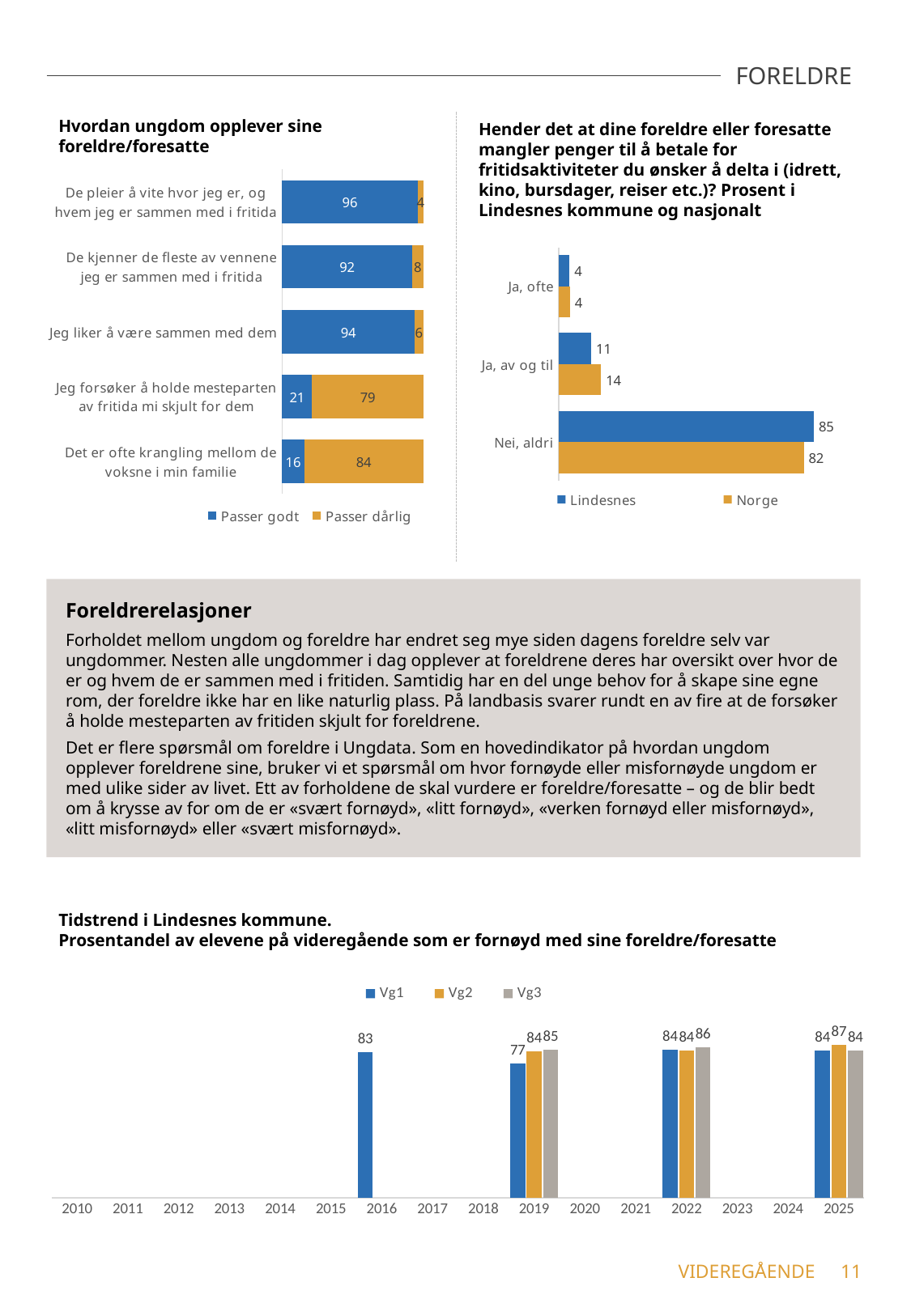
In the chart 'Hvordan ungdom opplever sine foreldre/foresatte', how many series does the legend list? 2 In the chart 'Hender det at dine foreldre eller foresatte mangler penger...', how many categories are shown? 3 In the chart 'Hvordan ungdom opplever sine foreldre/foresatte', what is the 'Passer godt' value for 'De pleier å vite hvor jeg er, og hvem jeg er sammen med i fritida'? 96 In the chart 'Hvordan ungdom opplever sine foreldre/foresatte', which statement has the lowest 'Passer godt' value? Det er ofte krangling mellom de voksne i min familie In the chart 'Hender det at dine foreldre eller foresatte mangler penger...', which category has the highest Lindesnes value? Nei, aldri In the chart 'Tidstrend i Lindesnes kommune', what is the Vg1 value for 2019? 77 In the chart 'Hender det at dine foreldre eller foresatte mangler penger...', what is the difference between the Lindesnes and Norge values for 'Nei, aldri'? 3 In the chart 'Tidstrend i Lindesnes kommune', which is larger in 2022: the Vg1 value or the Vg3 value? Vg3 In the chart 'Hvordan ungdom opplever sine foreldre/foresatte', what is the 'Passer dårlig' value for 'Det er ofte krangling mellom de voksne i min familie'? 84 In the chart 'Hender det at dine foreldre eller foresatte mangler penger...', what is the Norge value for 'Ja, av og til'? 14 In the chart 'Tidstrend i Lindesnes kommune', what is the Vg2 value for 2025? 87 What kind of chart is 'Tidstrend i Lindesnes kommune'? Bar chart